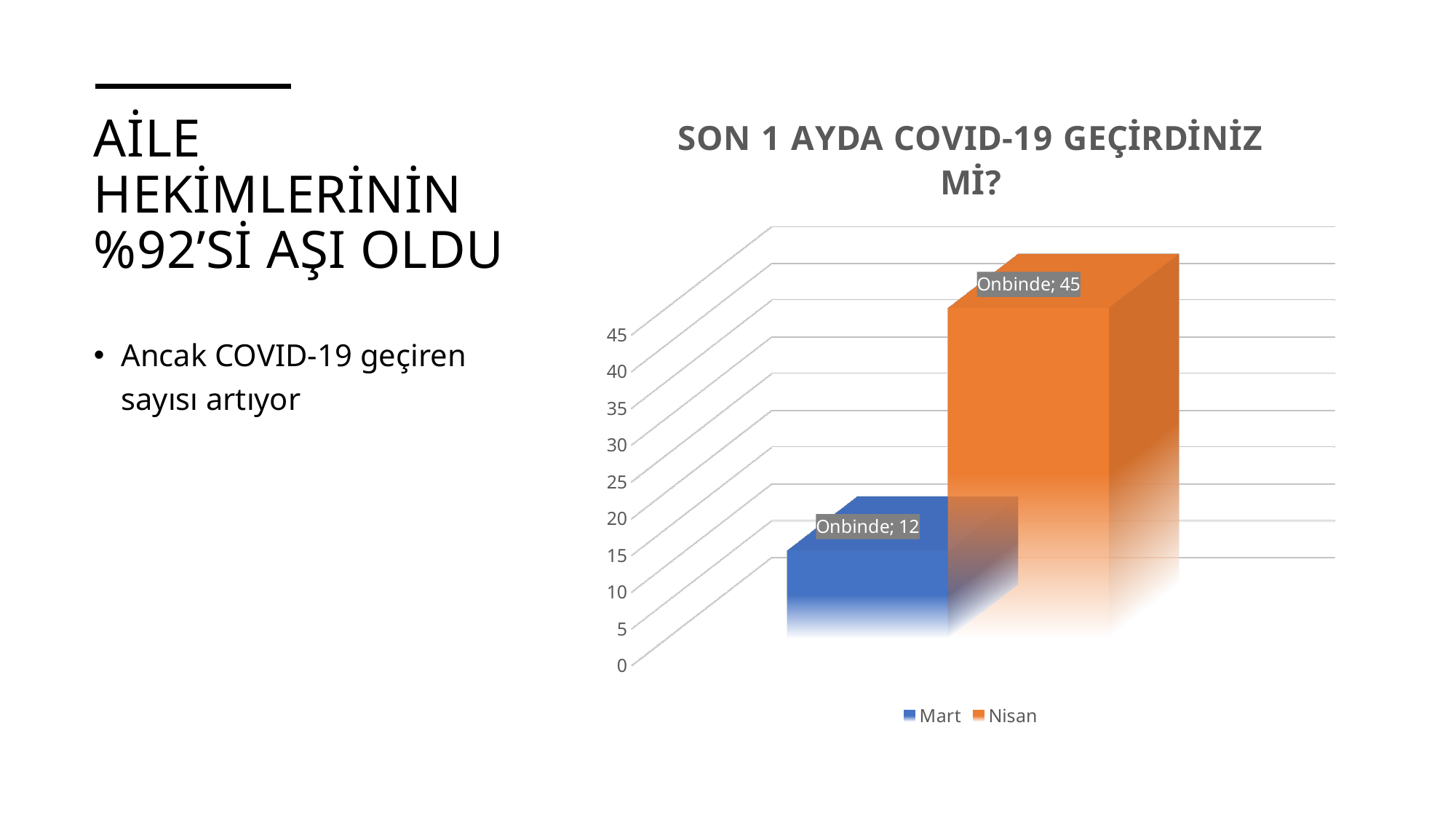
What is the title of the chart? SON 1 AYDA COVID-19 GEÇİRDİNİZ Mİ? Which series has the highest value in the chart? Nisan What is the value for Nisan in the chart? 45 What colour is the Nisan bar in the chart? Orange What is the difference between the Nisan value and the Mart value? 33 Which series has the lowest value in the chart? Mart How many series does the legend list? 2 What is the value for Mart in the chart? 12 Is the value for Nisan greater or less than 40? greater Is the value for Mart greater or less than 15? less Which series has the higher value, Mart or Nisan? Nisan What kind of chart is shown on the slide? Bar chart